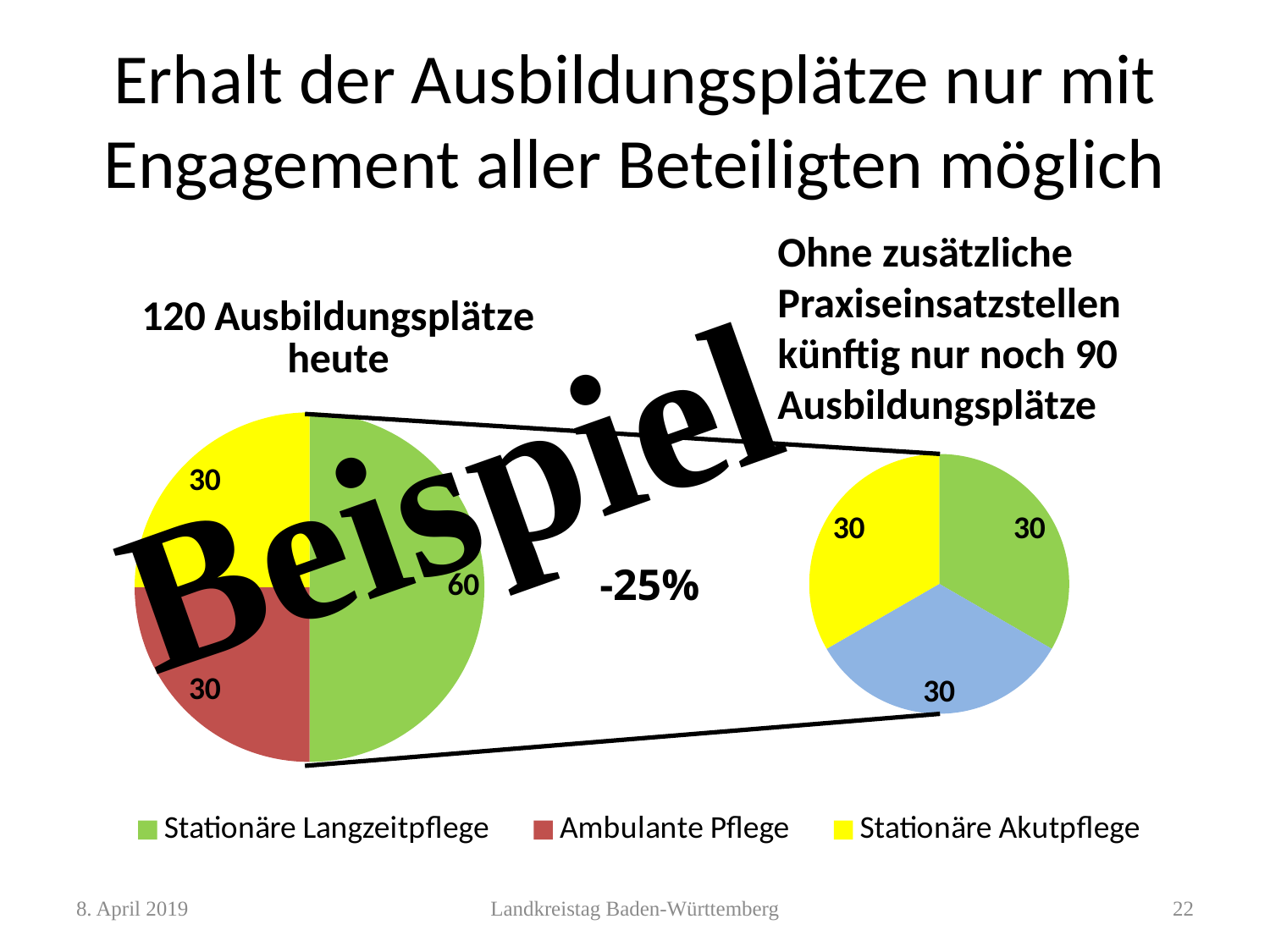
How many series does the legend list? 3 In the left chart (120 Ausbildungsplätze heute), what is the value for Ambulante Pflege? 30 In the left chart (120 Ausbildungsplätze heute), what is the difference between Stationäre Langzeitpflege and Ambulante Pflege? 30 How many slices does the right pie chart have? 3 In the left chart (120 Ausbildungsplätze heute), what is the value for Stationäre Langzeitpflege? 60 What kind of chart is the left chart titled "120 Ausbildungsplätze heute"? pie chart In the left chart (120 Ausbildungsplätze heute), which category has the largest slice? Stationäre Langzeitpflege In the right pie chart, what is the value of the yellow slice (Stationäre Akutpflege)? 30 In the left chart (120 Ausbildungsplätze heute), which is larger: Stationäre Langzeitpflege or Stationäre Akutpflege? Stationäre Langzeitpflege In the left chart (120 Ausbildungsplätze heute), what share of the pie does Stationäre Langzeitpflege represent? 50% In the left chart (120 Ausbildungsplätze heute), what is the value for Stationäre Akutpflege? 30 What percentage change is printed between the two pie charts? -25%